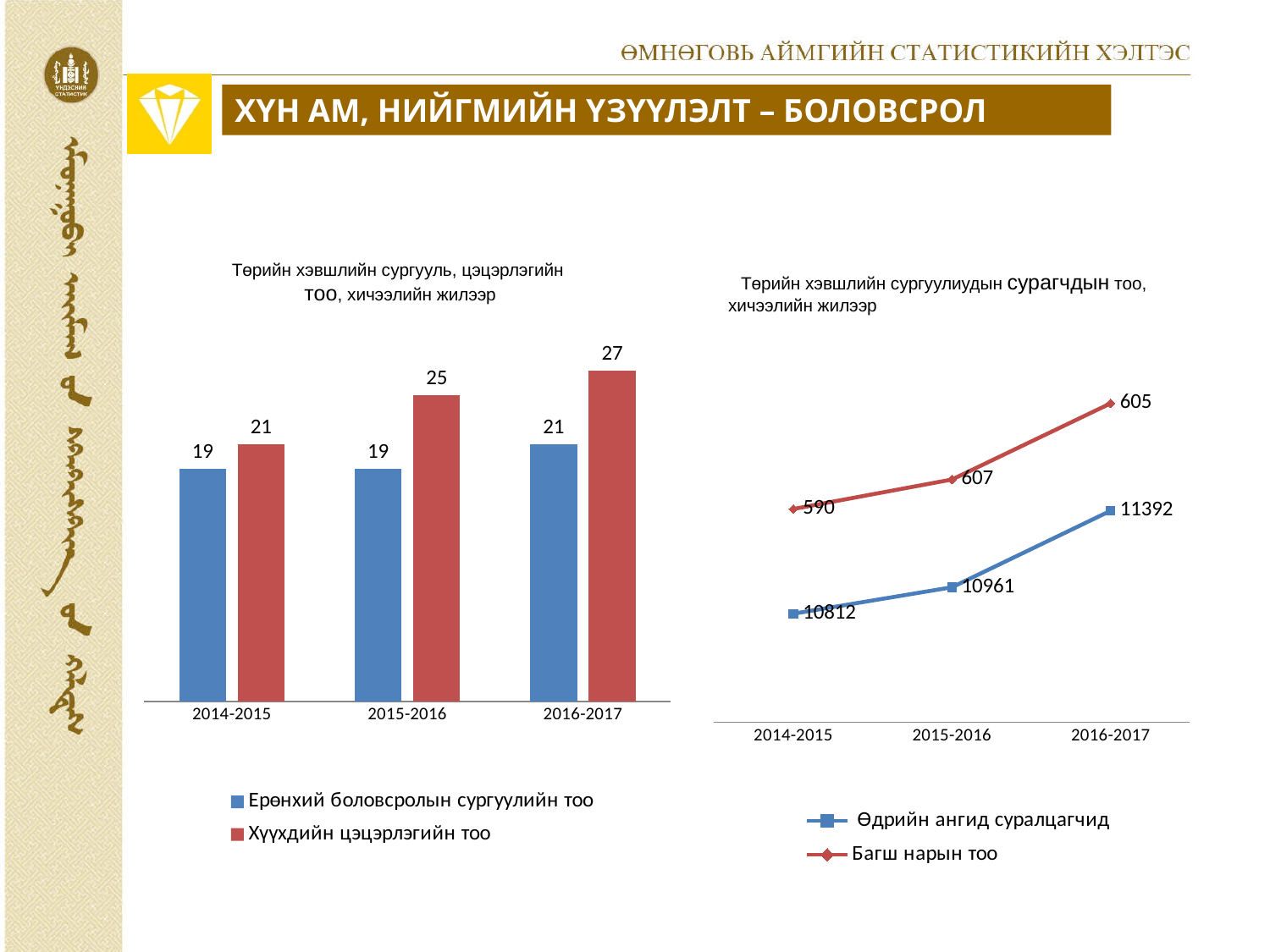
What kind of chart is the left chart? Bar chart In the left bar chart, what is the value for Ерөнхий боловсролын сургуулийн тоо in 2016-2017? 21 In the left bar chart, how many series does the legend list? 2 How many school years are shown on the x axis of the right line chart? 3 In the right line chart, what is the difference in Өдрийн ангид суралцагчид between 2016-2017 and 2014-2015? 580 In the left bar chart, what is the difference between Хүүхдийн цэцэрлэгийн тоо and Ерөнхий боловсролын сургуулийн тоо in 2016-2017? 6 In the right line chart, what is the value for Багш нарын тоо in 2015-2016? 607 In the left bar chart, what is the value for Хүүхдийн цэцэрлэгийн тоо in 2015-2016? 25 In the right line chart, what is the value for Өдрийн ангид суралцагчид in 2016-2017? 11392 In the left bar chart, which school year has the highest value for Хүүхдийн цэцэрлэгийн тоо? 2016-2017 In the right line chart, which school year has the lowest value for Өдрийн ангид суралцагчид? 2014-2015 In the right line chart, does Өдрийн ангид суралцагчид rise or fall from 2014-2015 to 2016-2017? Rise